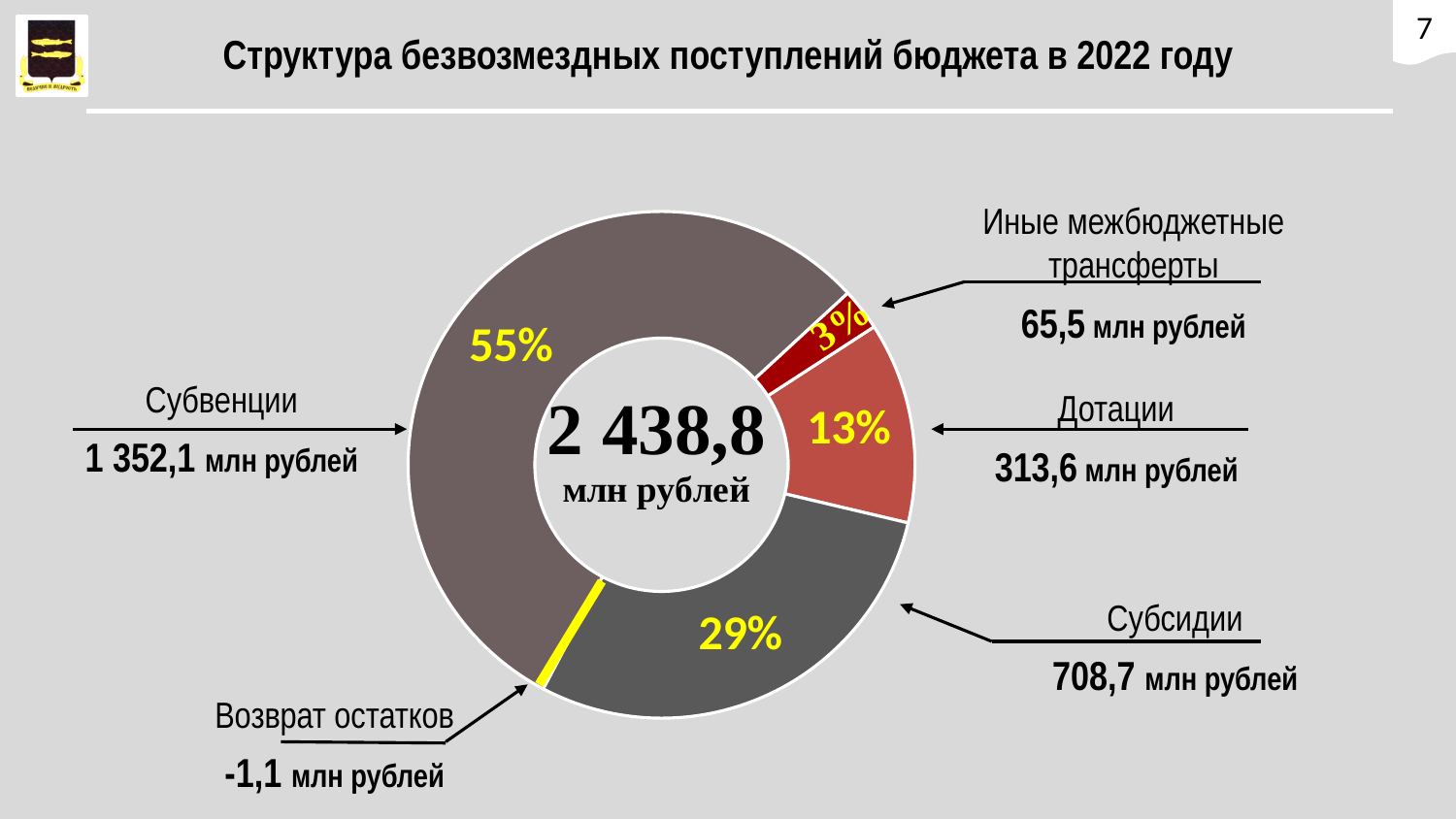
What is the value for Возврат остатков? -1,1 млн рублей What is the value for Субвенции? 1 352,1 млн рублей What share of the chart does Субсидии represent? 29% What is the value for Иные межбюджетные трансферты? 65,5 млн рублей What is the difference between the values for Субвенции and Субсидии? 643,4 млн рублей What kind of chart is shown on the slide? Donut (pie) chart What share of the chart does Дотации represent? 13% What is the value for Дотации? 313,6 млн рублей What is the value for Субсидии? 708,7 млн рублей Which category has the smallest value? Возврат остатков What total is shown in the centre of the donut chart? 2 438,8 млн рублей Which category has the largest value? Субвенции